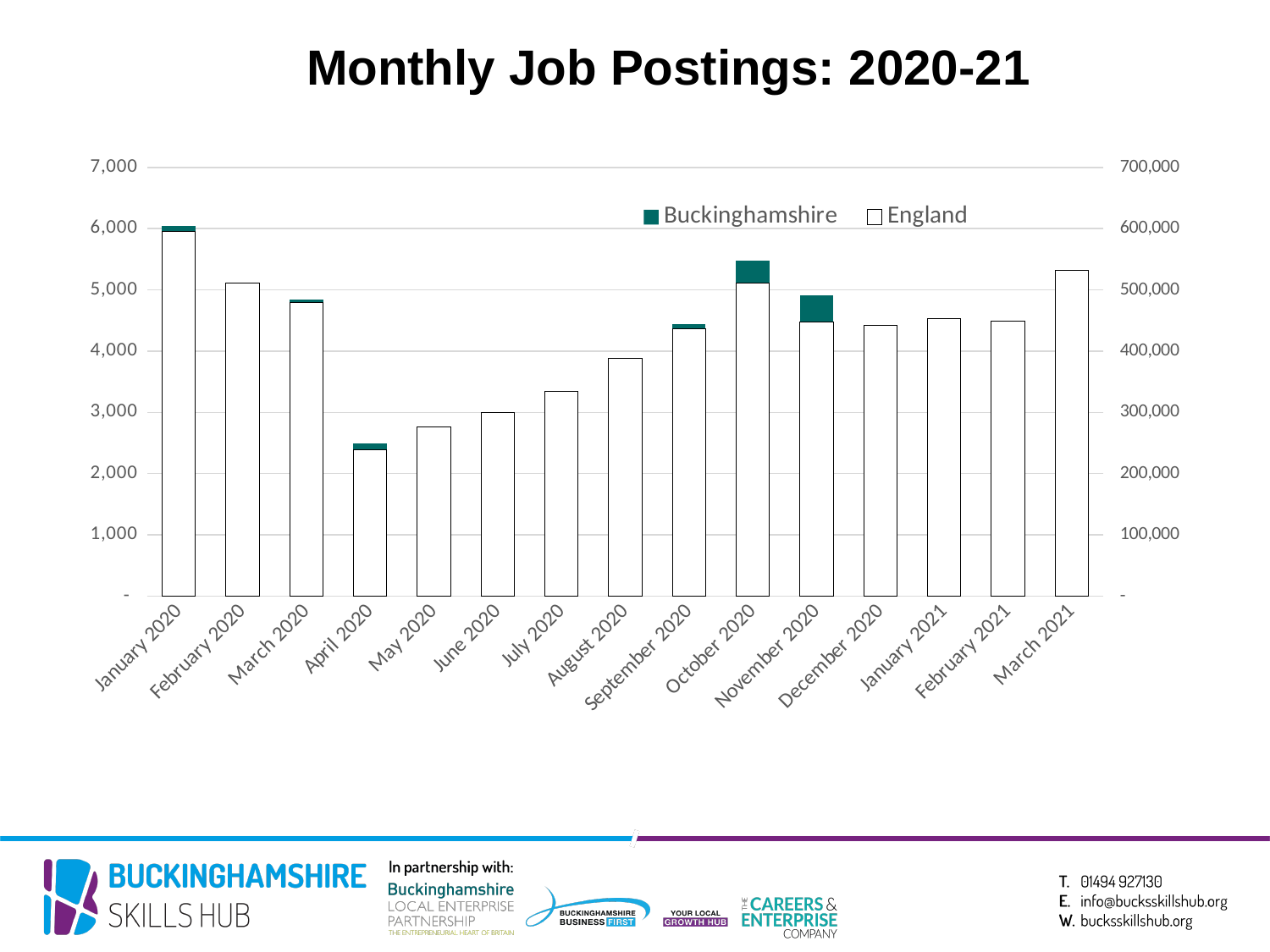
Which two series are shown in the legend? Buckinghamshire and England How many series does the legend list? 2 Do the bars rise or fall from April 2020 to October 2020? Rise Which bar is taller, January 2020 or February 2020? January 2020 Which month has the shortest bar? April 2020 What kind of chart is shown on the slide? Bar chart Which month has the tallest bar? January 2020 Is the bar for April 2020 greater or less than 3,000 on the left axis? less How many months are shown along the x axis? 15 Is the bar for January 2020 greater or less than 5,000 on the left axis? greater Which bar is taller, July 2020 or August 2020? August 2020 What is the title of the chart? Monthly Job Postings: 2020-21